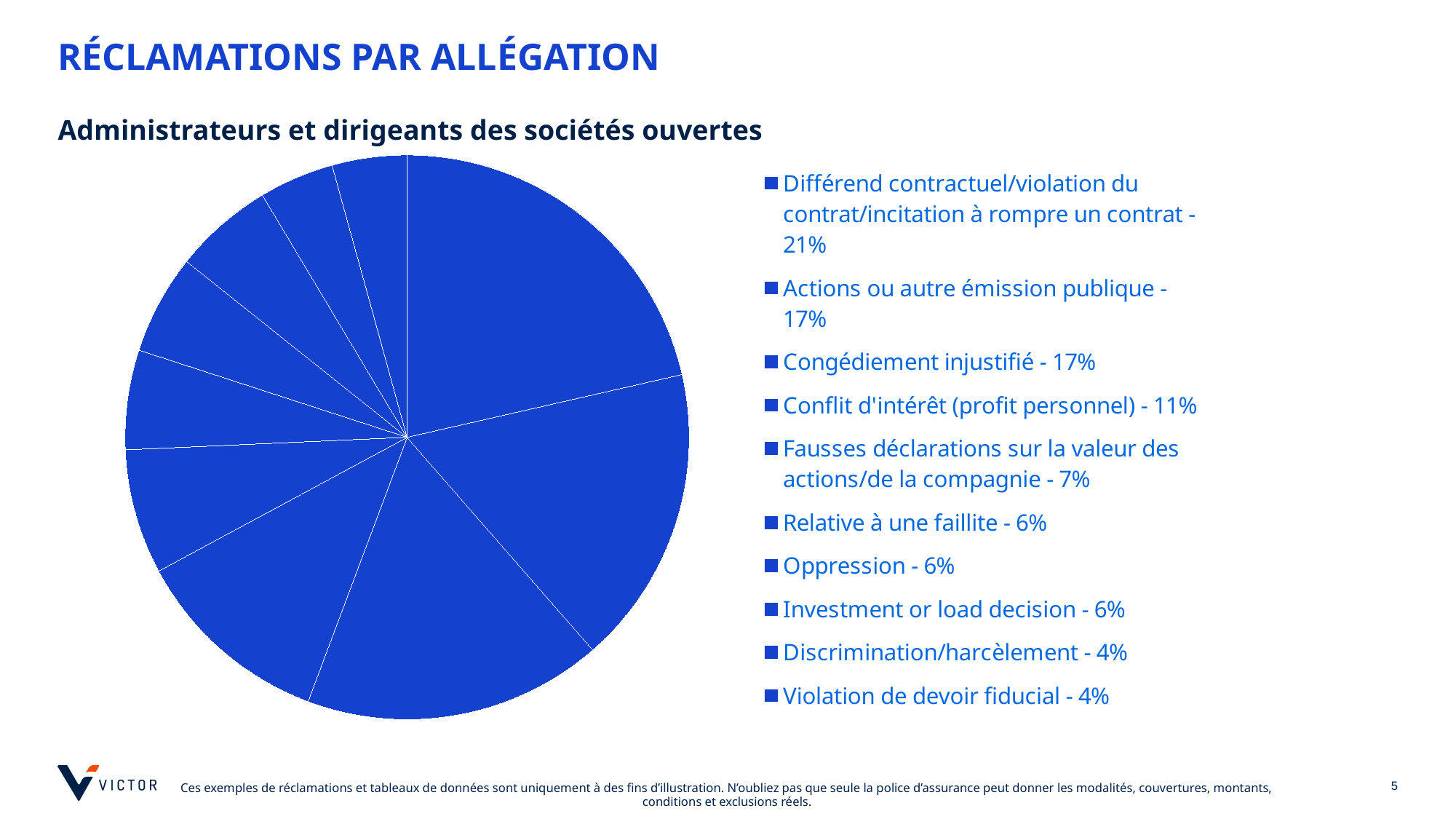
What share of claims is attributed to "Congédiement injustifié"? 17% What is the subtitle shown above the pie chart? Administrateurs et dirigeants des sociétés ouvertes Which category has the largest share of the pie? Différend contractuel/violation du contrat/incitation à rompre un contrat What percentage is shown for "Relative à une faillite"? 6% What percentage is shown for "Fausses déclarations sur la valeur des actions/de la compagnie"? 7% What percentage is shown for "Conflit d'intérêt (profit personnel)"? 11% What is the difference in percentage points between "Conflit d'intérêt (profit personnel)" and "Violation de devoir fiducial"? 7 What kind of chart is shown on the slide? pie chart Which is larger: the share for "Oppression" or the share for "Discrimination/harcèlement"? Oppression What is the smallest percentage shown in the legend? 4% What is the difference in percentage points between "Différend contractuel/violation du contrat/incitation à rompre un contrat" and "Actions ou autre émission publique"? 4 How many categories does the pie chart show? 10